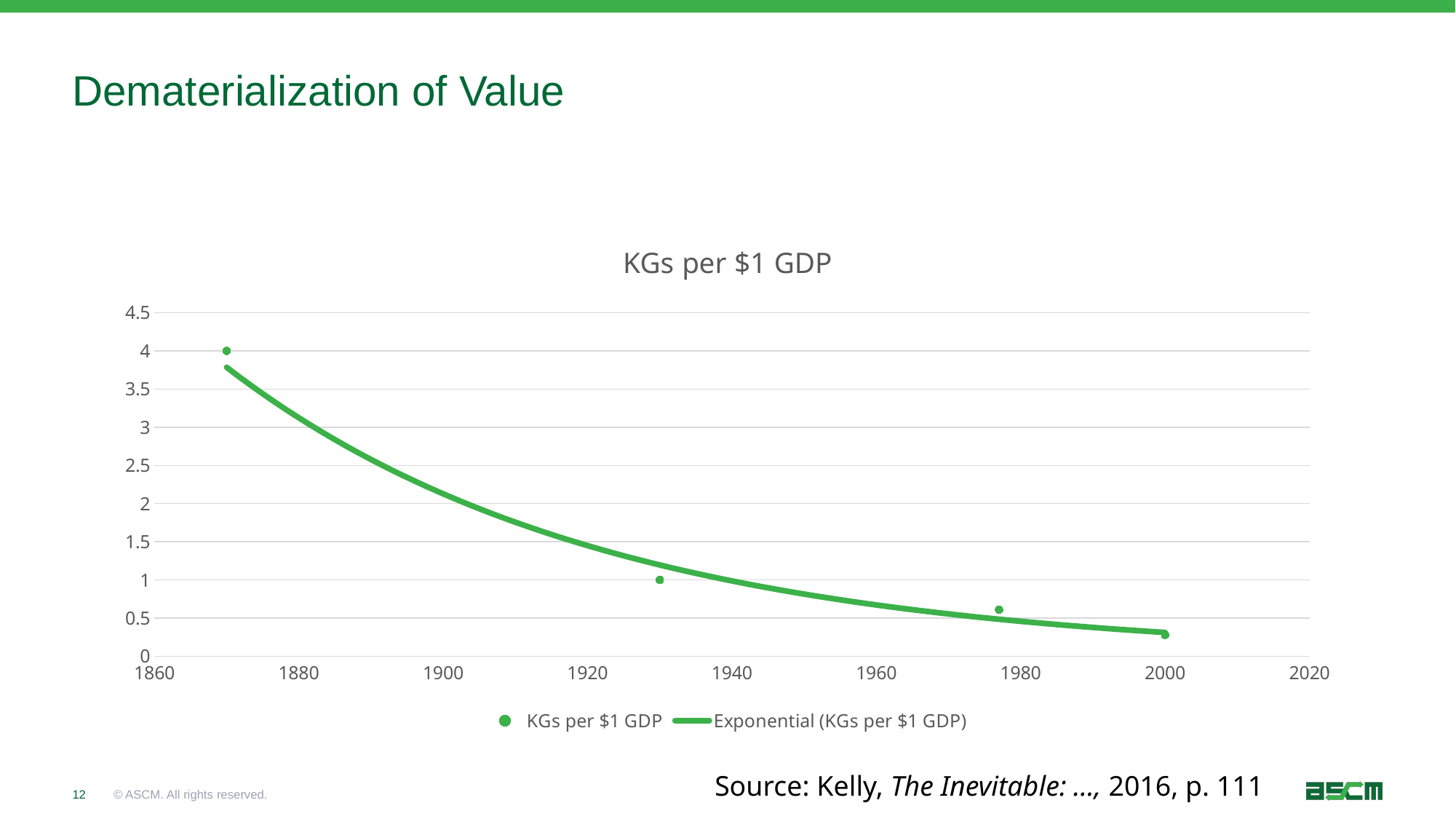
What is the title of the chart? KGs per $1 GDP What is the value of the earliest plotted data point (around 1870)? 4 What is the name of the trendline series in the legend? Exponential (KGs per $1 GDP) Do the KGs per $1 GDP values rise or fall as the years increase? Fall Which plotted point has the highest KGs per $1 GDP value? The earliest point, around 1870 How many entries does the chart legend list? 2 What kind of chart is shown on the slide? Scatter chart with an exponential trendline What is the value of the data point plotted around 1930? 1 How many data points are plotted in the chart? 4 Is the value of the data point plotted around 1977 greater or less than 0.5? greater Which plotted point has the lowest KGs per $1 GDP value? The point at 2000 Is the value of the data point at 2000 greater or less than 0.5? less